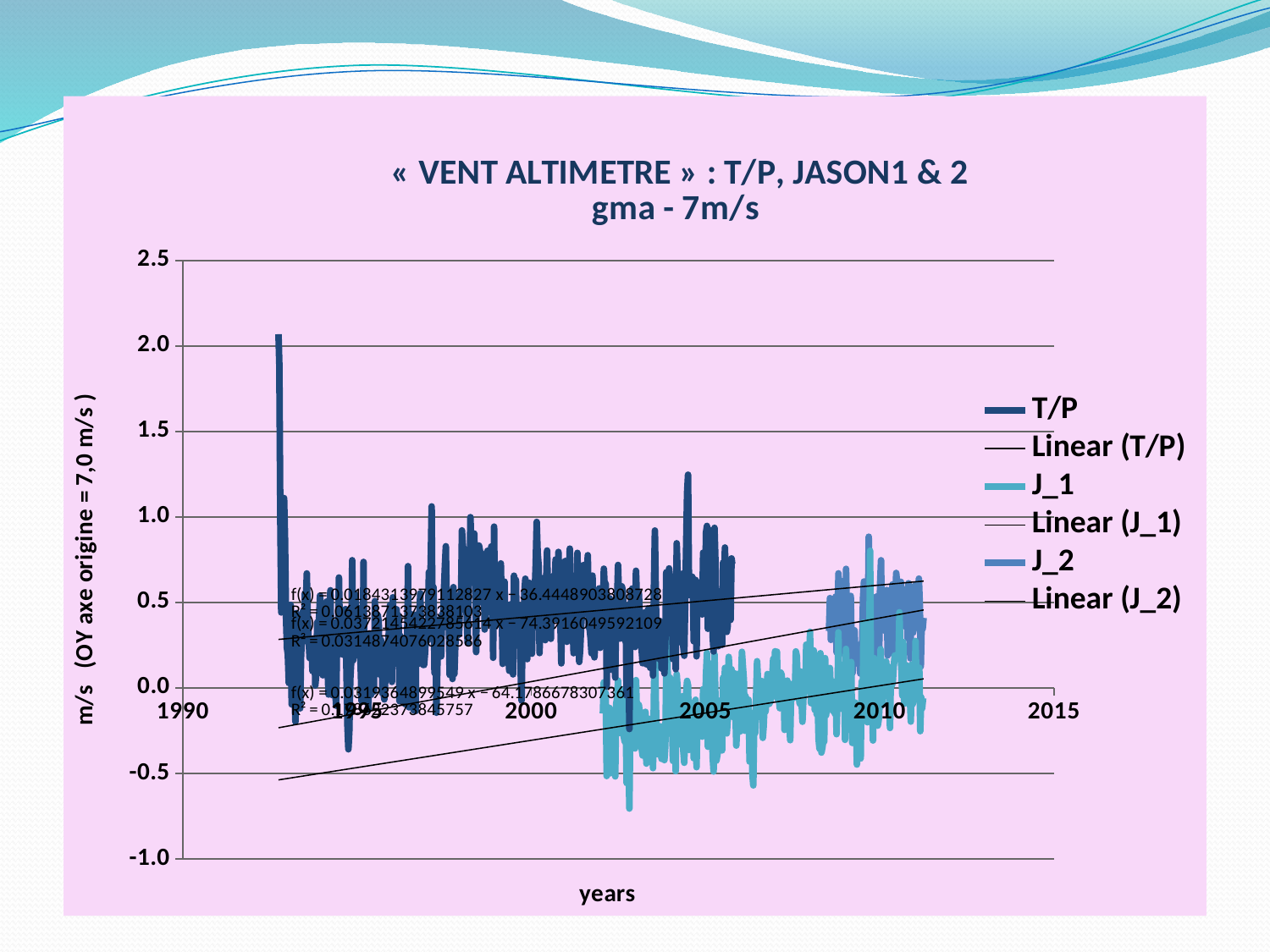
Does the linear trendline for J_2 rise or fall from left to right? rise Is the lowest value of the J_1 series greater or less than -0.5? less Which series in the legend is drawn in the darkest blue? T/P Are most values of the J_2 series greater or less than 0.0? greater Which series covers the earliest years on the x axis, T/P or J_2? T/P Are most values of the J_1 series greater or less than 0.0? less What kind of chart is shown on the slide? line chart What is the label of the x axis? years How many entries does the chart legend list? 6 What is the title of the chart? « VENT ALTIMETRE » : T/P, JASON1 & 2 gma - 7m/s Does the linear trendline for J_1 rise or fall from left to right? rise